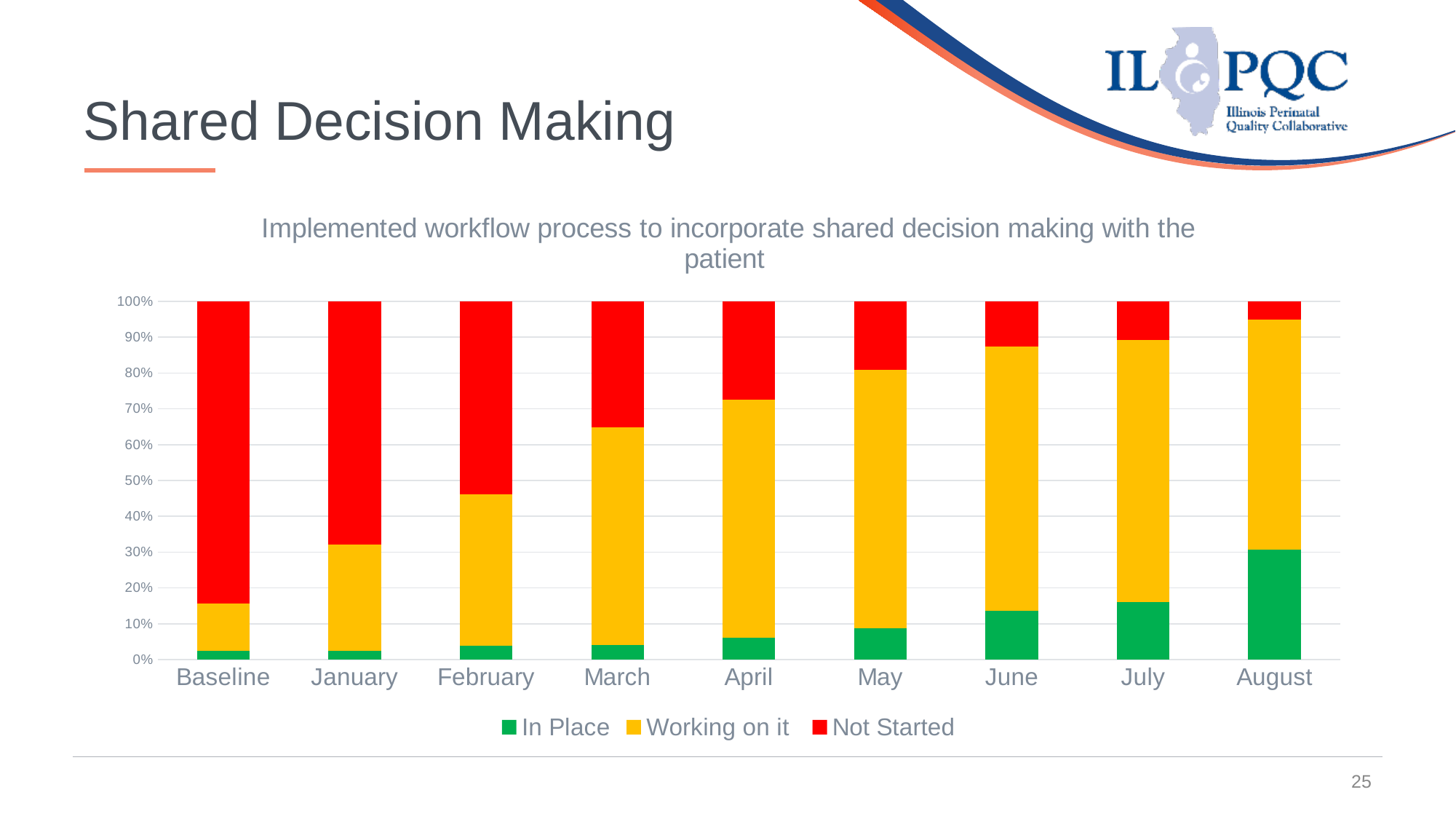
Does the In Place share rise or fall from Baseline to August? rise Is the In Place share for August greater or less than 20%? greater Does the Not Started share rise or fall from Baseline to August? fall Is the Not Started share for Baseline greater or less than 80%? greater Which month has the smallest Not Started share? August Which month has the largest In Place share? August What colour represents the Not Started series in the legend? Red Which has a larger Not Started share, January or March? January What kind of chart is shown on the slide? Stacked bar chart How many series does the legend list? 3 Which category has the largest Not Started share? Baseline How many time-period categories are shown along the x axis? 9